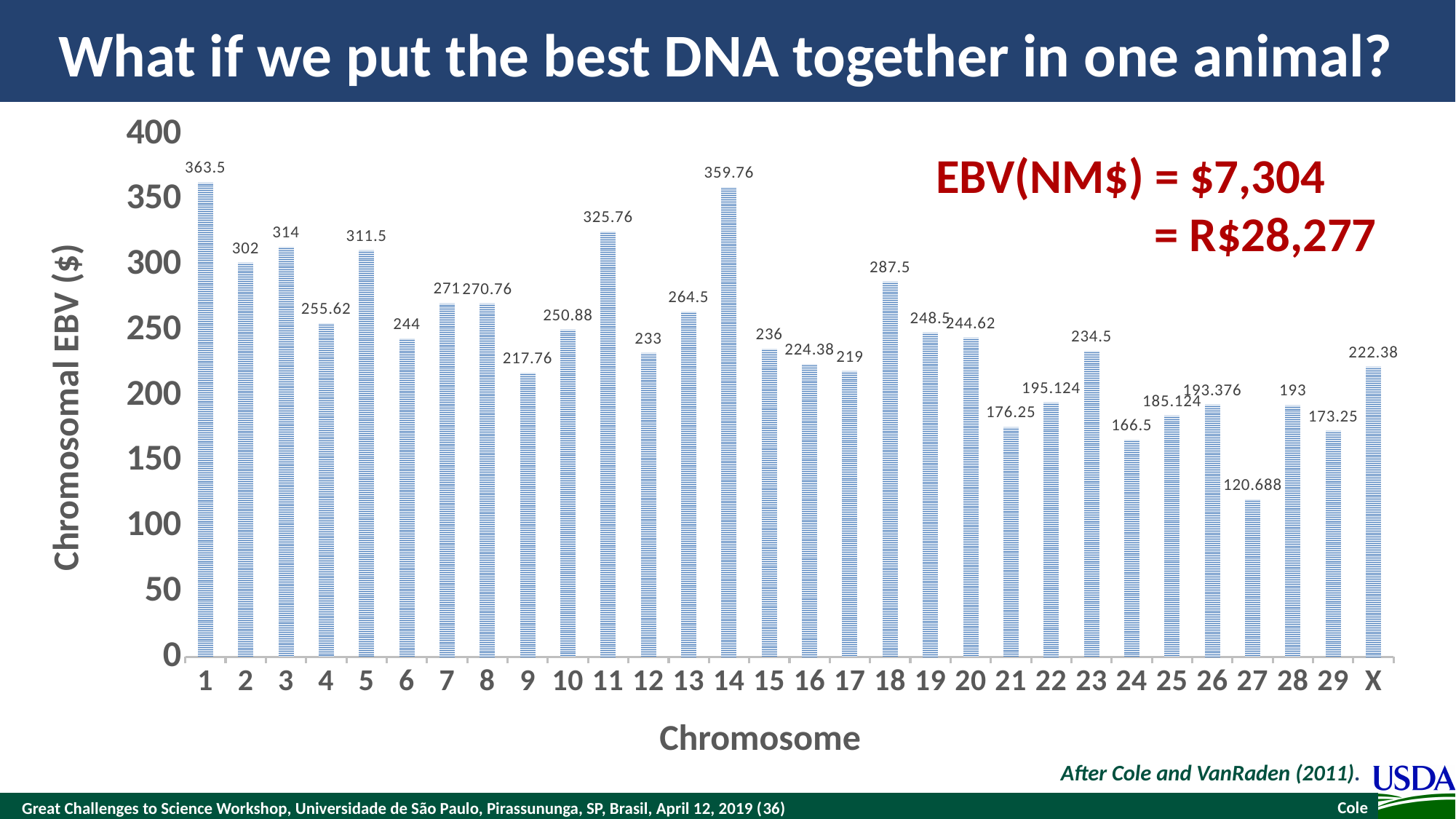
Which chromosome has the lowest chromosomal EBV ($)? 27 Which has a larger chromosomal EBV ($), chromosome 11 or chromosome 18? Chromosome 11 Which chromosome has the highest chromosomal EBV ($)? 1 What kind of chart is shown on the slide? Bar chart What is the difference in chromosomal EBV ($) between chromosome 1 and chromosome 14? 3.74 What is the label of the y axis? Chromosomal EBV ($) How many chromosomes are plotted on the x axis? 30 What is the difference in chromosomal EBV ($) between chromosome 3 and chromosome 2? 12 What is the chromosomal EBV ($) for chromosome 14? 359.76 What is the chromosomal EBV ($) for chromosome 1? 363.5 What is the chromosomal EBV ($) for chromosome 27? 120.688 What is the chromosomal EBV ($) for chromosome X? 222.38